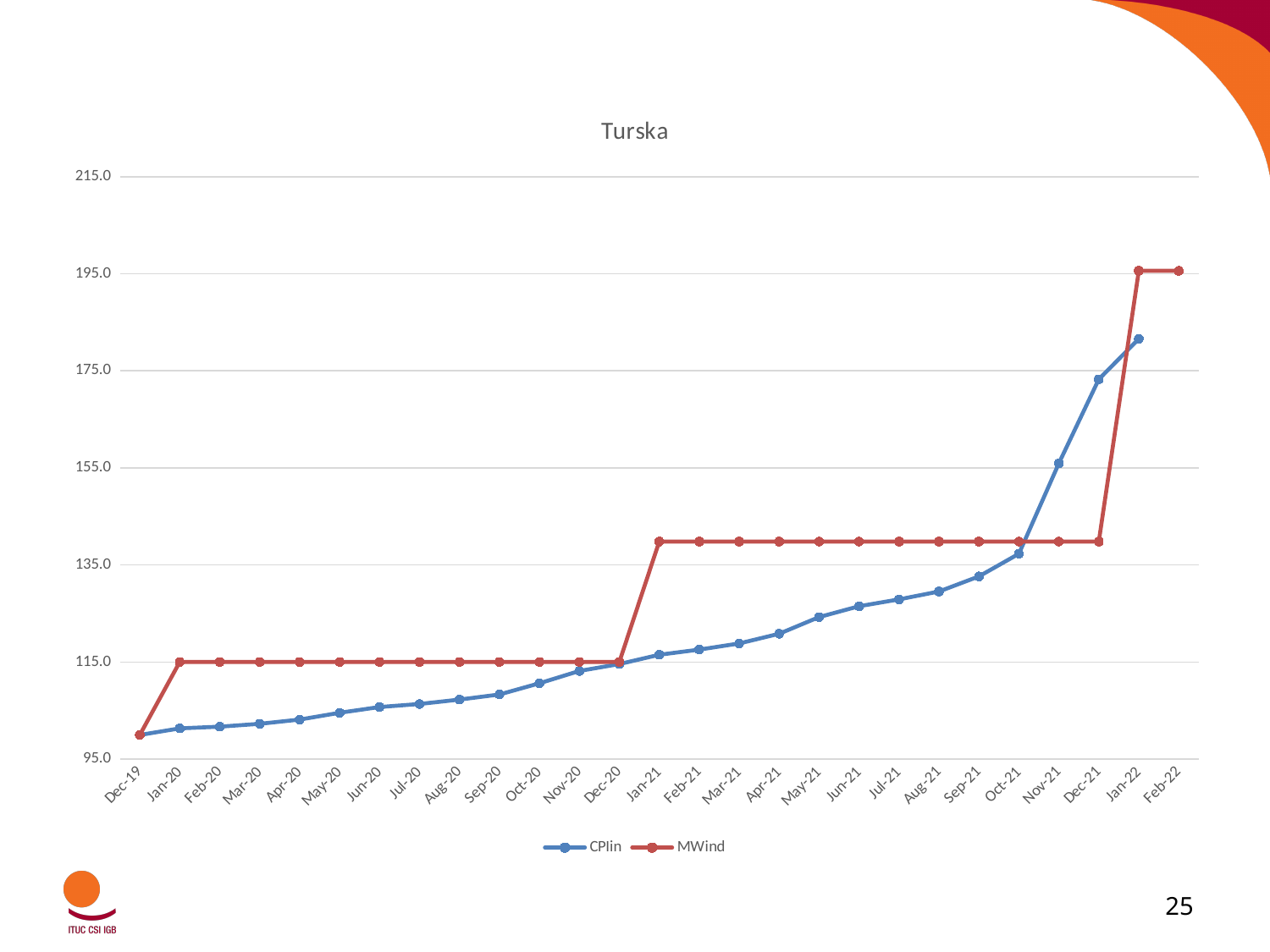
In Nov-21, which series has the higher value, CPIin or MWind? CPIin What is the title of the chart? Turska Does the CPIin series rise or fall from Dec-19 to Feb-22? rise How many series does the legend list? 2 What is the value of MWind in Jan-20? 115.0 How many months are plotted along the x axis? 27 Is the value of CPIin in Jun-21 greater or less than 135.0? less What kind of chart is shown on the slide? line chart Is the value of MWind in Jan-21 greater or less than 135.0? greater What are the names of the two series in the legend? CPIin and MWind